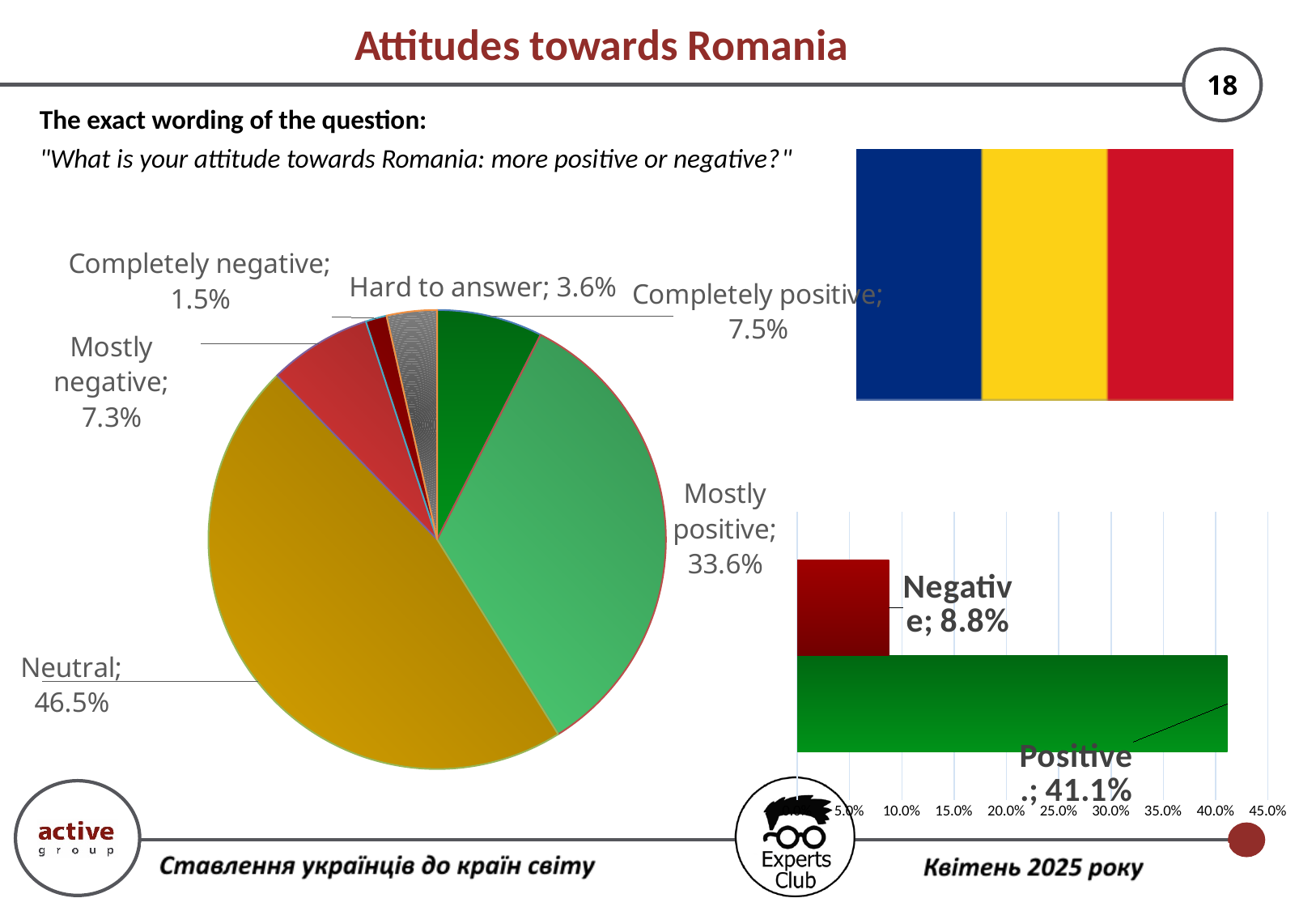
In the bar chart at the bottom right, what is the value for "Negative"? 8.8% In the pie chart, which is larger: "Completely positive" or "Mostly negative"? Completely positive In the pie chart, what share of respondents answered "Completely negative"? 1.5% What kind of chart is shown at the bottom right of the slide? Bar chart In the bar chart at the bottom right, what is the value for "Positive"? 41.1% In the pie chart, which category has the smallest share? Completely negative In the pie chart, what share of respondents answered "Mostly positive"? 33.6% In the pie chart, which category has the largest share? Neutral In the pie chart, what is the difference between "Mostly positive" and "Mostly negative"? 26.3% In the pie chart, what share of respondents answered "Neutral"? 46.5% In the bar chart at the bottom right, what is the difference between "Positive" and "Negative"? 32.3% In the pie chart, how many categories are shown? 6